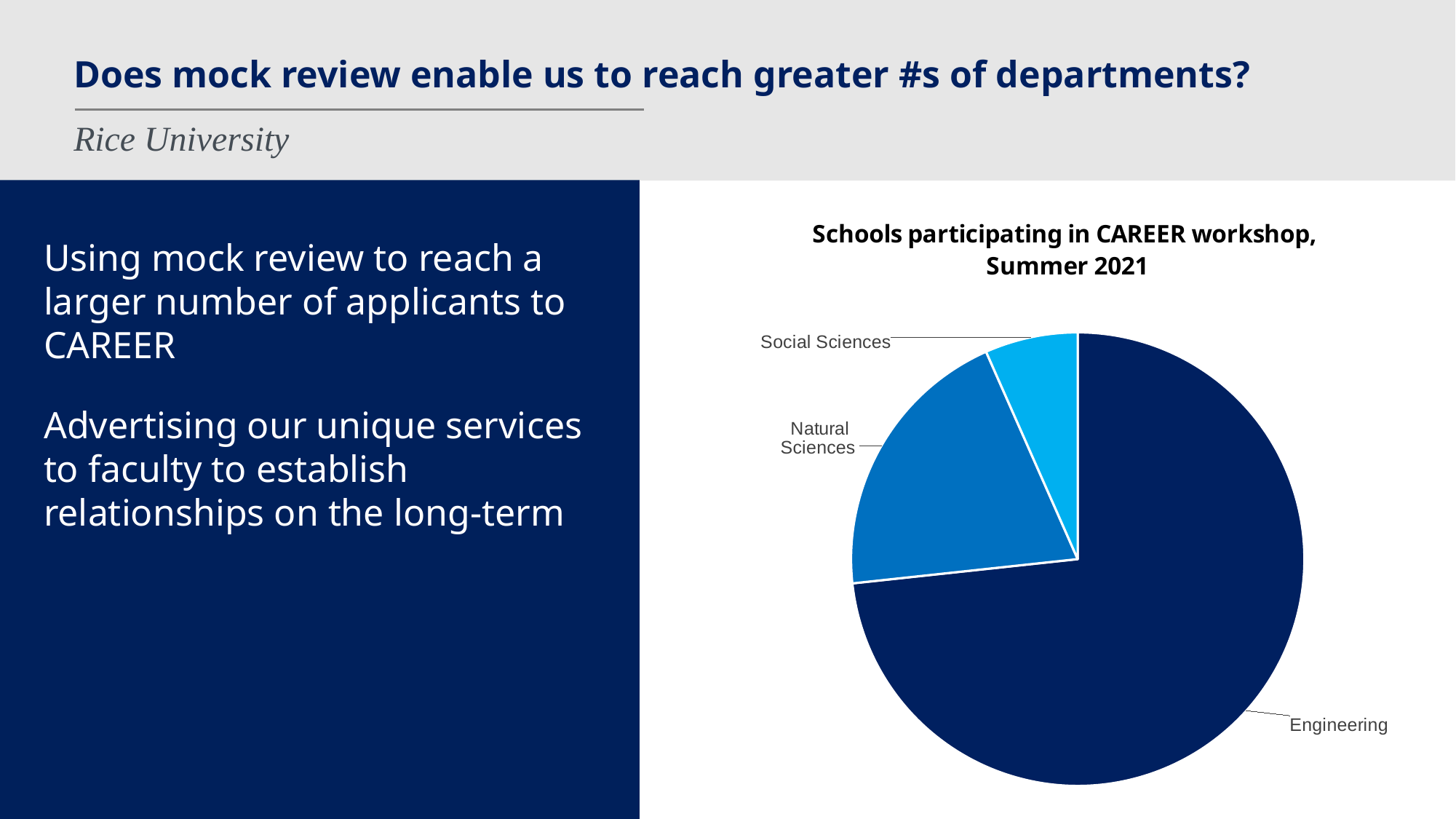
Which schools are labelled on the pie chart? Engineering, Natural Sciences, Social Sciences Which school's slice is shown in the lightest blue colour? Social Sciences Which slice is larger, Natural Sciences or Social Sciences? Natural Sciences Which school has the smallest slice of the pie chart? Social Sciences Which school has the largest slice of the pie chart? Engineering What is the title of the pie chart? Schools participating in CAREER workshop, Summer 2021 What kind of chart is shown on the slide? Pie chart Which slice is larger, Engineering or Natural Sciences? Engineering How many slices does the pie chart have? 3